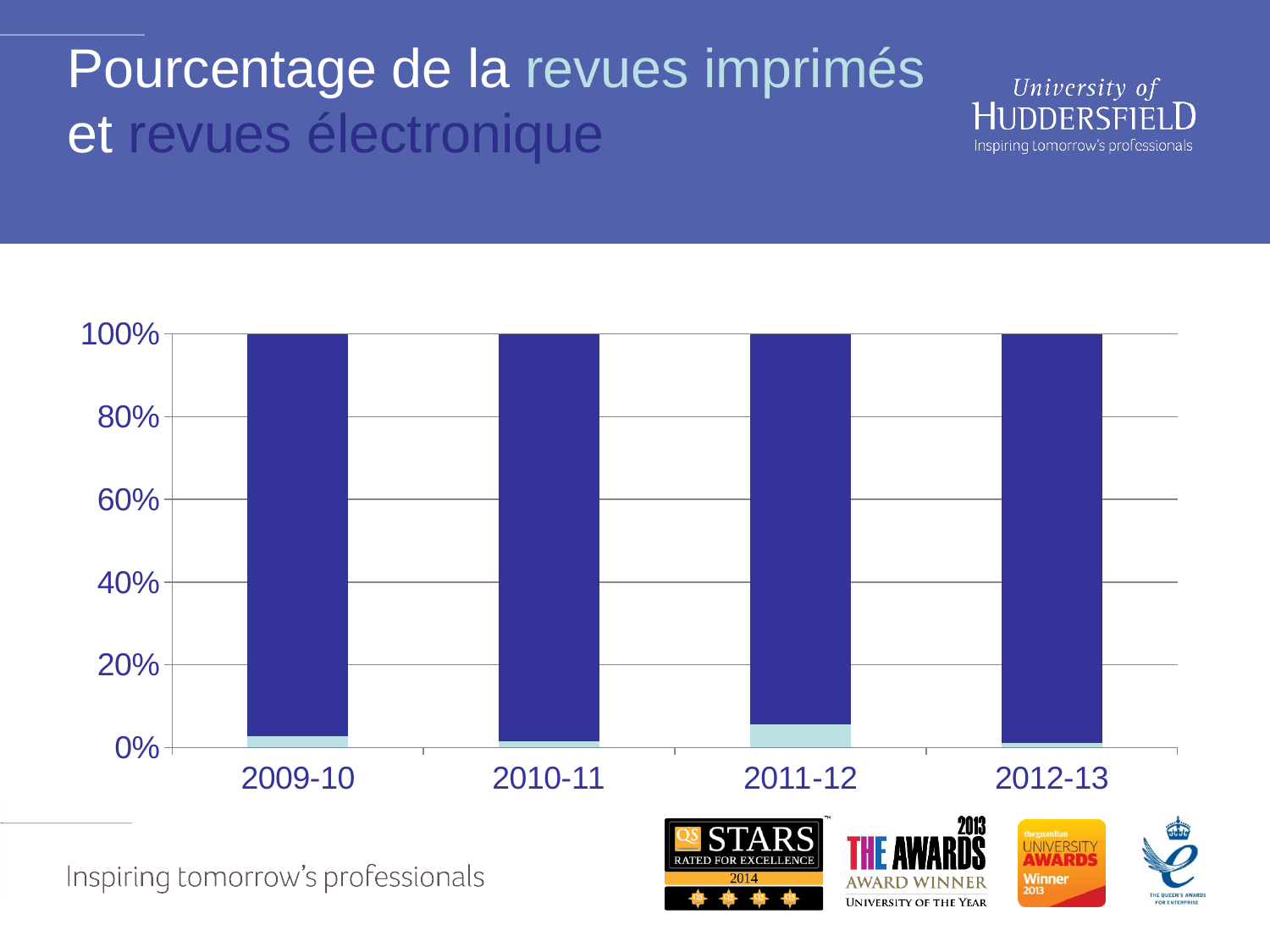
Which is larger, the light blue segment for 2011-12 or the light blue segment for 2012-13? 2011-12 Which is larger in 2012-13, the dark blue segment or the light blue segment? dark blue segment How many academic years are shown on the x axis of the chart? 4 Is the light blue (bottom) segment for 2009-10 greater or less than 20%? less What is the total height of the stacked bar for 2009-10? 100% What is the first year label on the x axis of the chart? 2009-10 What is the total height of the stacked bar for 2012-13? 100% Is the dark blue (top) segment for 2010-11 greater or less than 80%? greater In which year is the light blue (bottom) segment the largest? 2011-12 Is the light blue (bottom) segment for 2011-12 greater or less than 20%? less What is the highest value shown on the y axis of the chart? 100% What kind of chart is shown on the slide? stacked bar chart